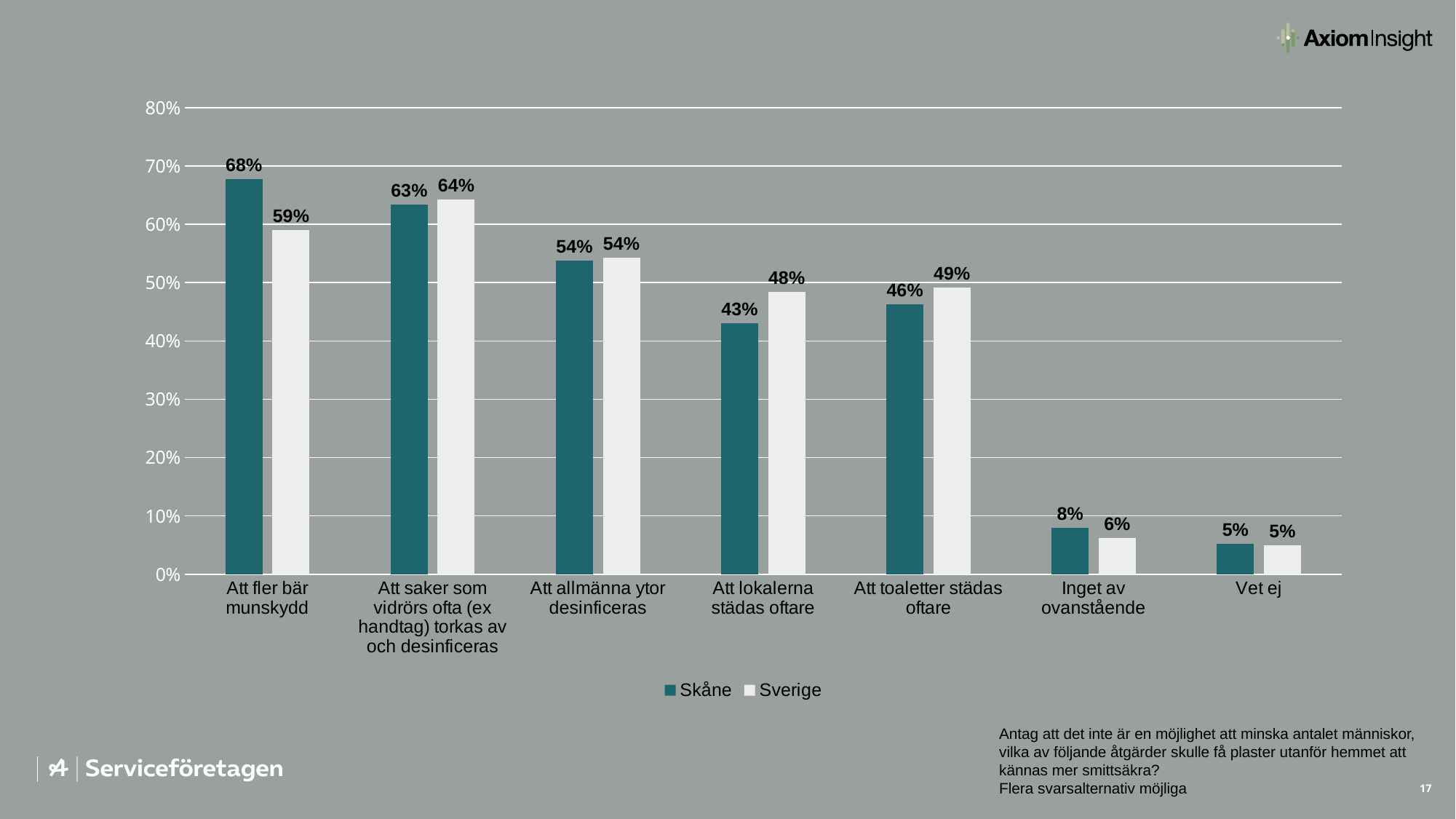
What is the value for Sverige for "Att lokalerna städas oftare"? 48% Which category has the highest value for Skåne? Att fler bär munskydd How many series does the legend list? 2 Which category has the lowest value for Sverige? Vet ej How many categories are shown on the x axis? 7 What is the difference between the Skåne and Sverige values for "Att fler bär munskydd"? 9% What are the two series named in the legend? Skåne and Sverige What is the value for Skåne for "Att toaletter städas oftare"? 46% What kind of chart is shown on the slide? Bar chart For "Att lokalerna städas oftare", which is larger: the Skåne value or the Sverige value? Sverige What is the value for Skåne for "Att fler bär munskydd"? 68% Is the Sverige value for "Att saker som vidrörs ofta (ex handtag) torkas av och desinficeras" greater or less than 60%? greater